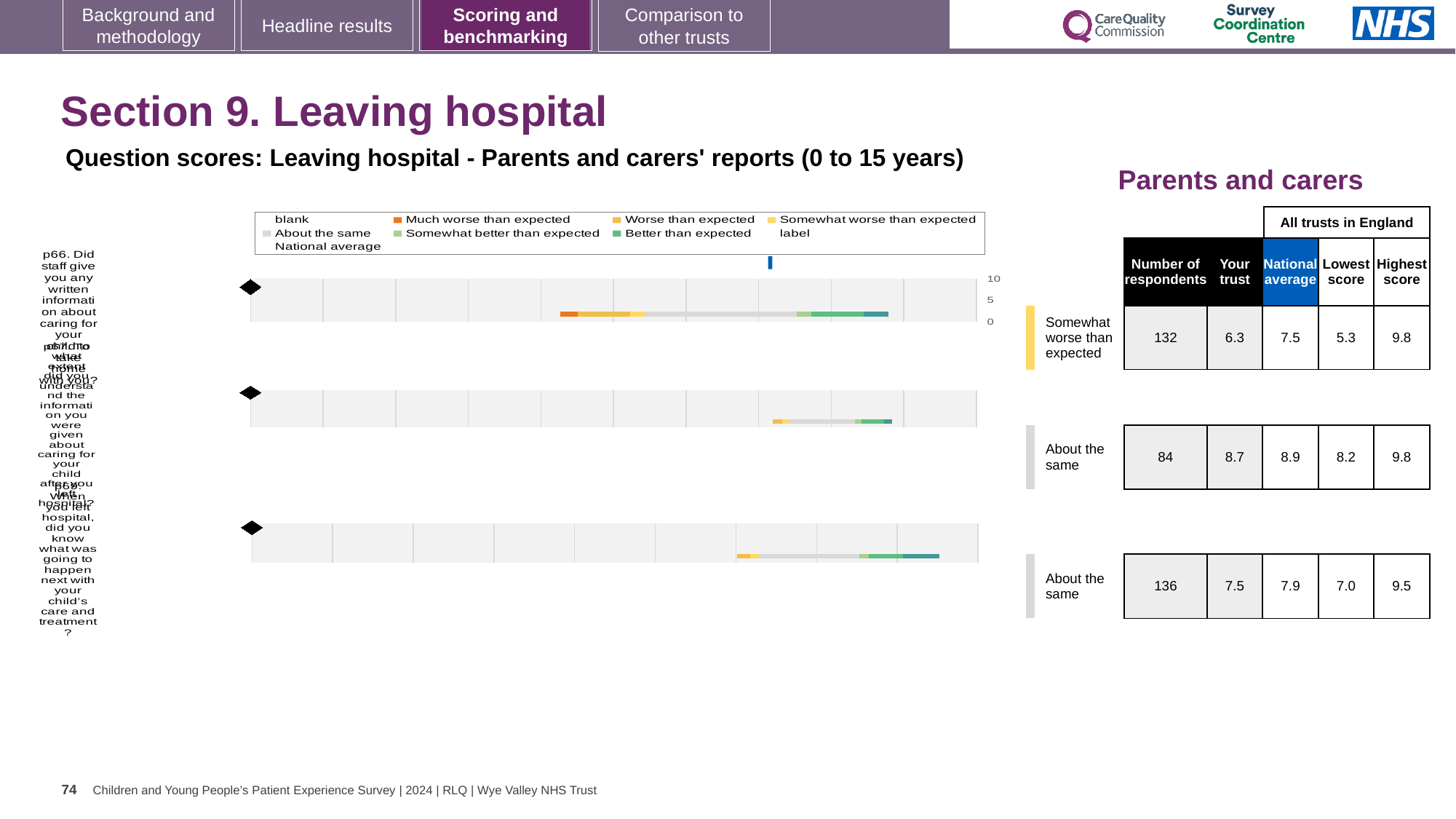
In the table next to the charts, which row has the highest 'Your trust' score? the middle row (8.7) In the table next to the charts, what is the 'Your trust' score for the top row (rated 'Somewhat worse than expected')? 6.3 What kind of chart is used for the three question rows on the left of the slide? bar chart In the table next to the charts, what is the national average for the bottom row? 7.9 In the table next to the charts, which row has the lowest 'Lowest score' value? the top row (5.3) How many entries does the legend above the bar charts list? 9 In the table next to the charts, what is the number of respondents for the middle row? 84 In the table next to the charts, which has more respondents, the top row or the bottom row? the bottom row (136) What is the maximum value shown on the axis of the top bar chart? 10 In the legend, which colour represents 'Much worse than expected'? orange In the table next to the charts, what is the difference between the national average and the 'Your trust' score for the top row? 1.2 How many separate bar charts are shown on the slide? 3